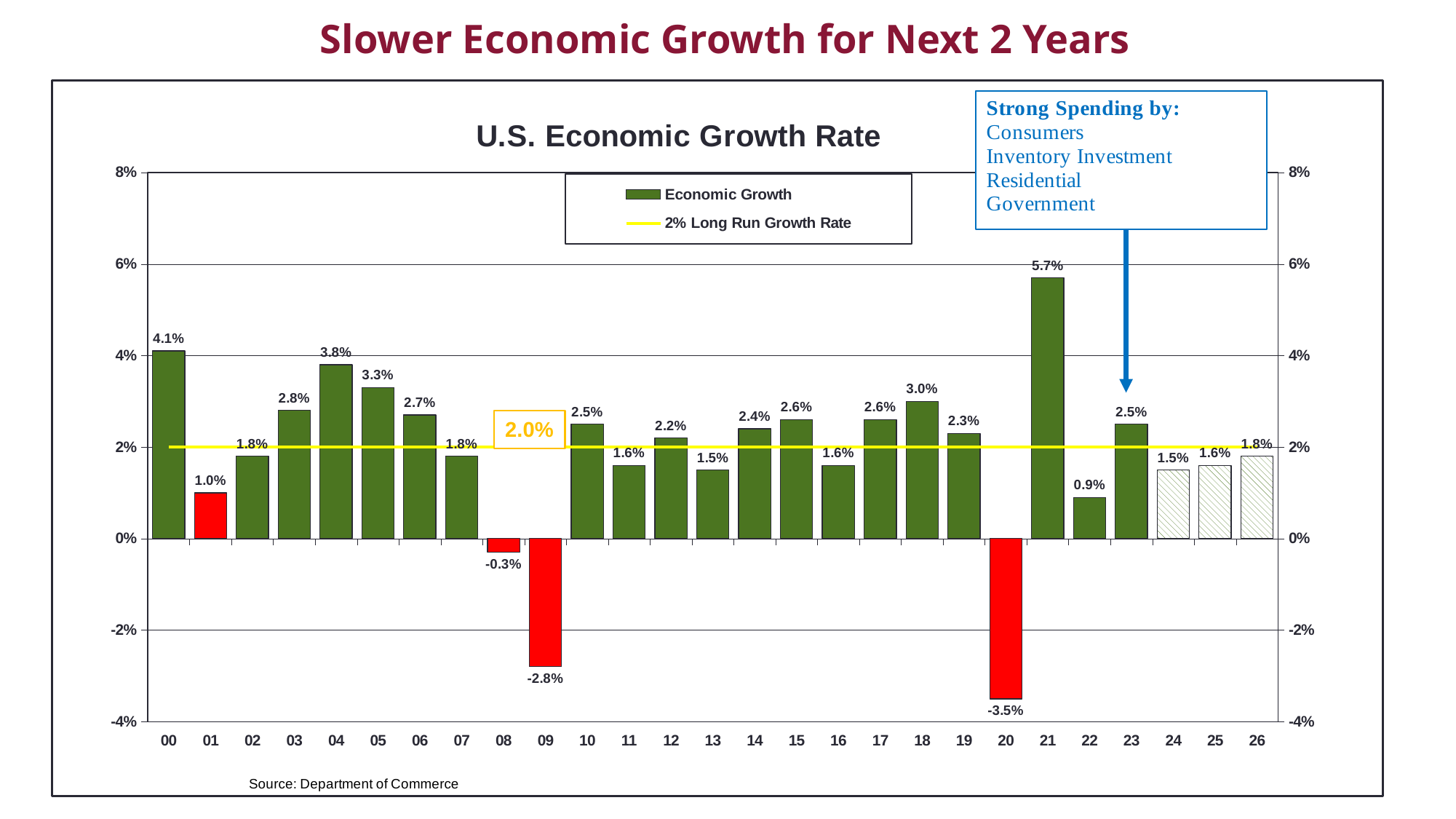
Which year has a higher economic growth rate, 04 or 18? 04 What is the economic growth rate shown for 09? -2.8% What is the difference between the economic growth rate in 21 and in 22? 4.8% Which year has the lowest economic growth rate? 20 Which year has the highest economic growth rate? 21 How many entries does the legend list? 2 What kind of chart is this? Combination bar and line chart What is the economic growth rate shown for 24? 1.5% What is the economic growth rate shown for 21? 5.7% How many years are shown on the x axis? 27 What is the title of the chart? U.S. Economic Growth Rate Do the economic growth rates rise or fall from 24 to 26? Rise